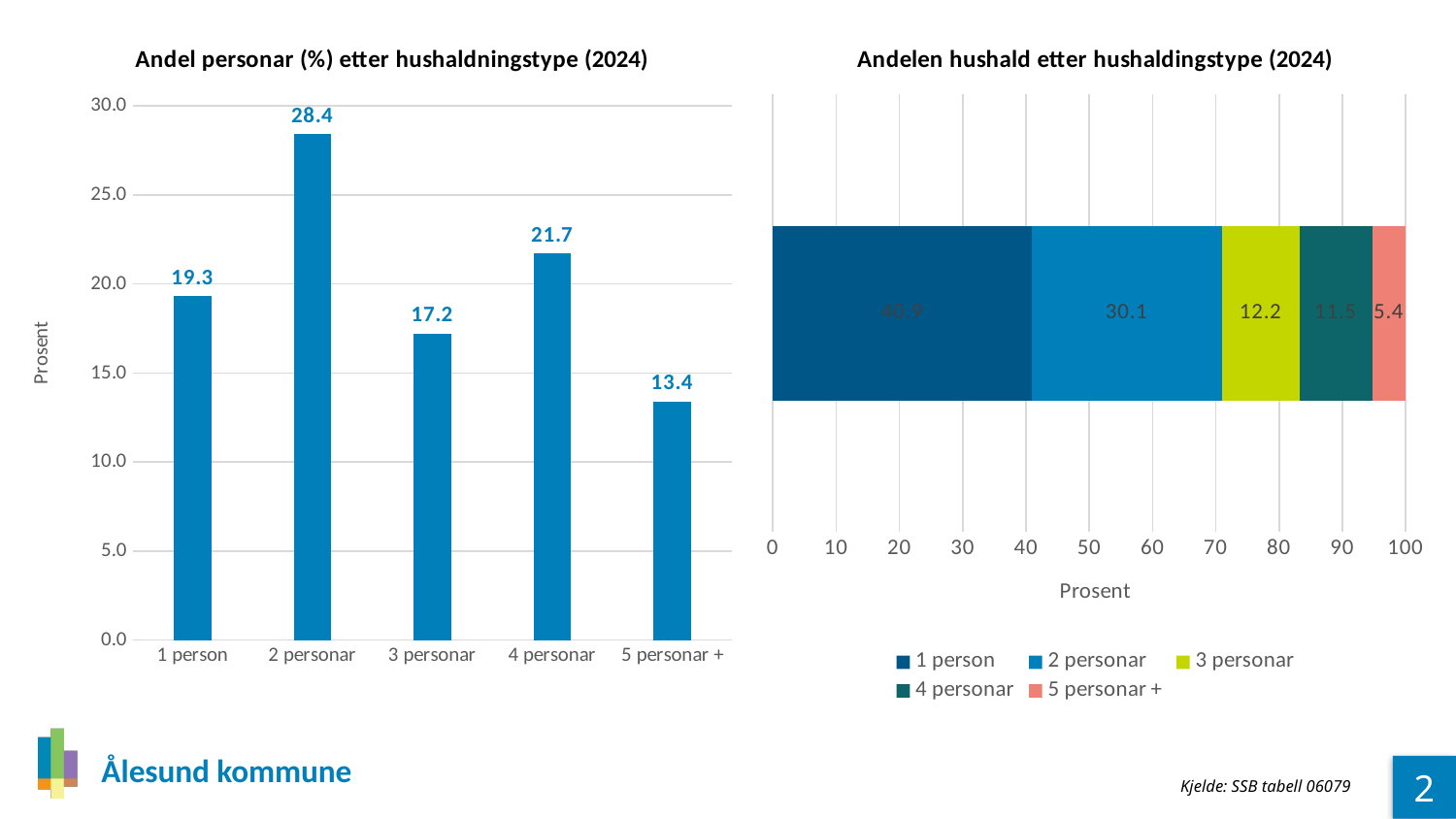
In the left chart 'Andel personar (%) etter hushaldningstype (2024)', which household type has the highest value? 2 personar In the right chart 'Andelen hushald etter hushaldingstype (2024)', what is the value for 3 personar? 12.2 In the left chart 'Andel personar (%) etter hushaldningstype (2024)', which is larger: 3 personar or 4 personar? 4 personar In the left chart 'Andel personar (%) etter hushaldningstype (2024)', what is the value for 2 personar? 28.4 What kind of chart is the left chart 'Andel personar (%) etter hushaldningstype (2024)'? Bar chart How many series does the legend of the right chart 'Andelen hushald etter hushaldingstype (2024)' list? 5 How many household type categories are shown in the left chart 'Andel personar (%) etter hushaldningstype (2024)'? 5 In the right chart 'Andelen hushald etter hushaldingstype (2024)', what is the value for 2 personar? 30.1 In the left chart 'Andel personar (%) etter hushaldningstype (2024)', how much higher is the value for 2 personar than for 1 person? 9.1 In the right chart 'Andelen hushald etter hushaldingstype (2024)', what is the difference between the values for 2 personar and 3 personar? 17.9 In the left chart 'Andel personar (%) etter hushaldningstype (2024)', which household type has the lowest value? 5 personar + In the left chart 'Andel personar (%) etter hushaldningstype (2024)', what is the value for 5 personar +? 13.4